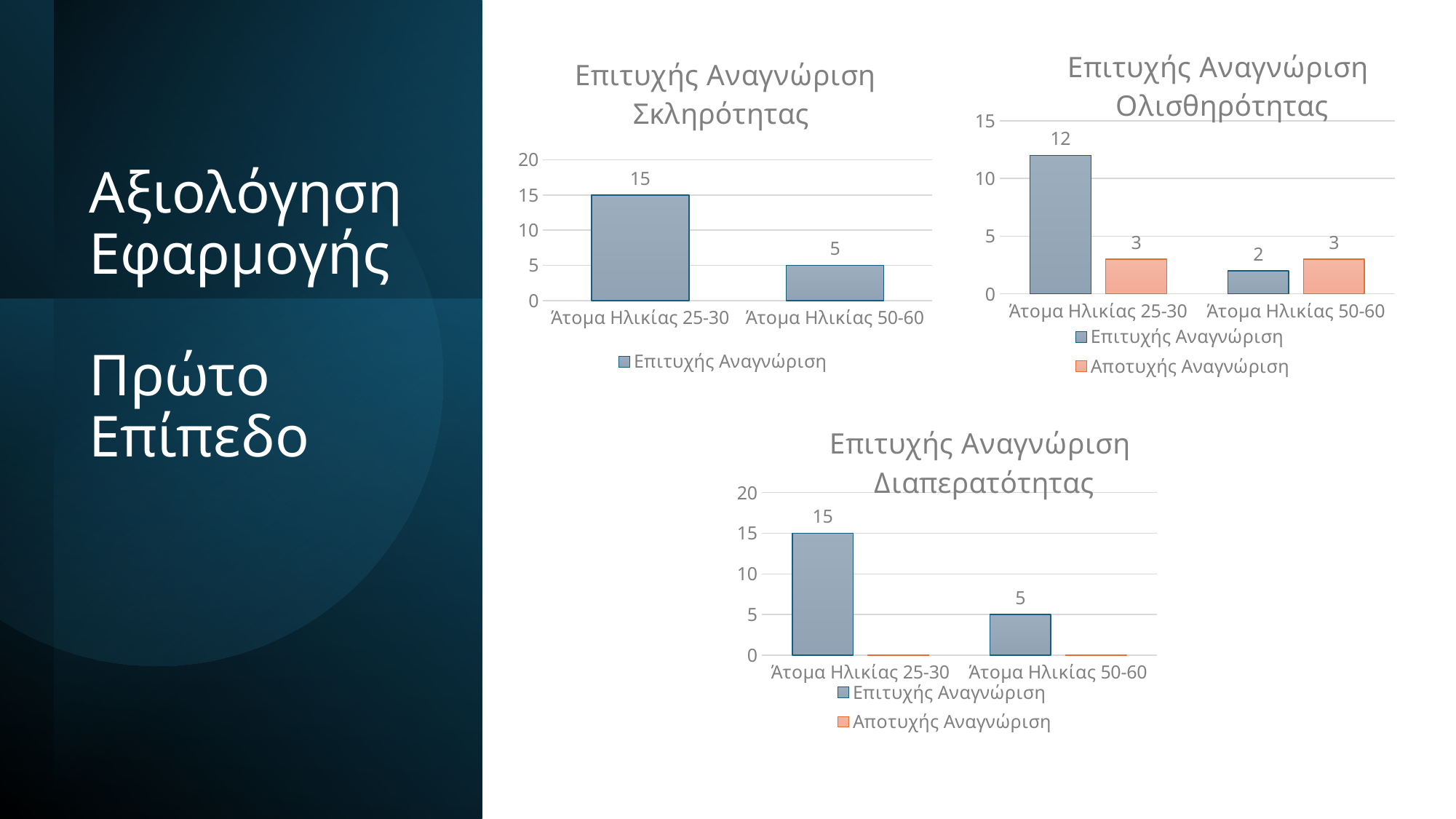
In the chart titled 'Επιτυχής Αναγνώριση Ολισθηρότητας', which is larger for Άτομα Ηλικίας 50-60: Επιτυχής Αναγνώριση or Αποτυχής Αναγνώριση? Αποτυχής Αναγνώριση In the chart titled 'Επιτυχής Αναγνώριση Σκληρότητας', what is the difference between the values for Άτομα Ηλικίας 25-30 and Άτομα Ηλικίας 50-60? 10 In the chart titled 'Επιτυχής Αναγνώριση Ολισθηρότητας', what is the Επιτυχής Αναγνώριση value for Άτομα Ηλικίας 25-30? 12 What kind of chart is the one titled 'Επιτυχής Αναγνώριση Σκληρότητας'? bar chart In the chart titled 'Επιτυχής Αναγνώριση Σκληρότητας', what is the value for Άτομα Ηλικίας 25-30? 15 In the chart titled 'Επιτυχής Αναγνώριση Σκληρότητας', what is the value for Άτομα Ηλικίας 50-60? 5 In the chart titled 'Επιτυχής Αναγνώριση Διαπερατότητας', what is the Επιτυχής Αναγνώριση value for Άτομα Ηλικίας 25-30? 15 In the chart titled 'Επιτυχής Αναγνώριση Ολισθηρότητας', how many series does the legend list? 2 In the chart titled 'Επιτυχής Αναγνώριση Ολισθηρότητας', is the Επιτυχής Αναγνώριση value for Άτομα Ηλικίας 25-30 greater or less than 10? greater In the chart titled 'Επιτυχής Αναγνώριση Διαπερατότητας', which category has the highest Επιτυχής Αναγνώριση value? Άτομα Ηλικίας 25-30 In the chart titled 'Επιτυχής Αναγνώριση Ολισθηρότητας', what is the Αποτυχής Αναγνώριση value for Άτομα Ηλικίας 50-60? 3 In the chart titled 'Επιτυχής Αναγνώριση Διαπερατότητας', how many categories are shown on the x axis? 2